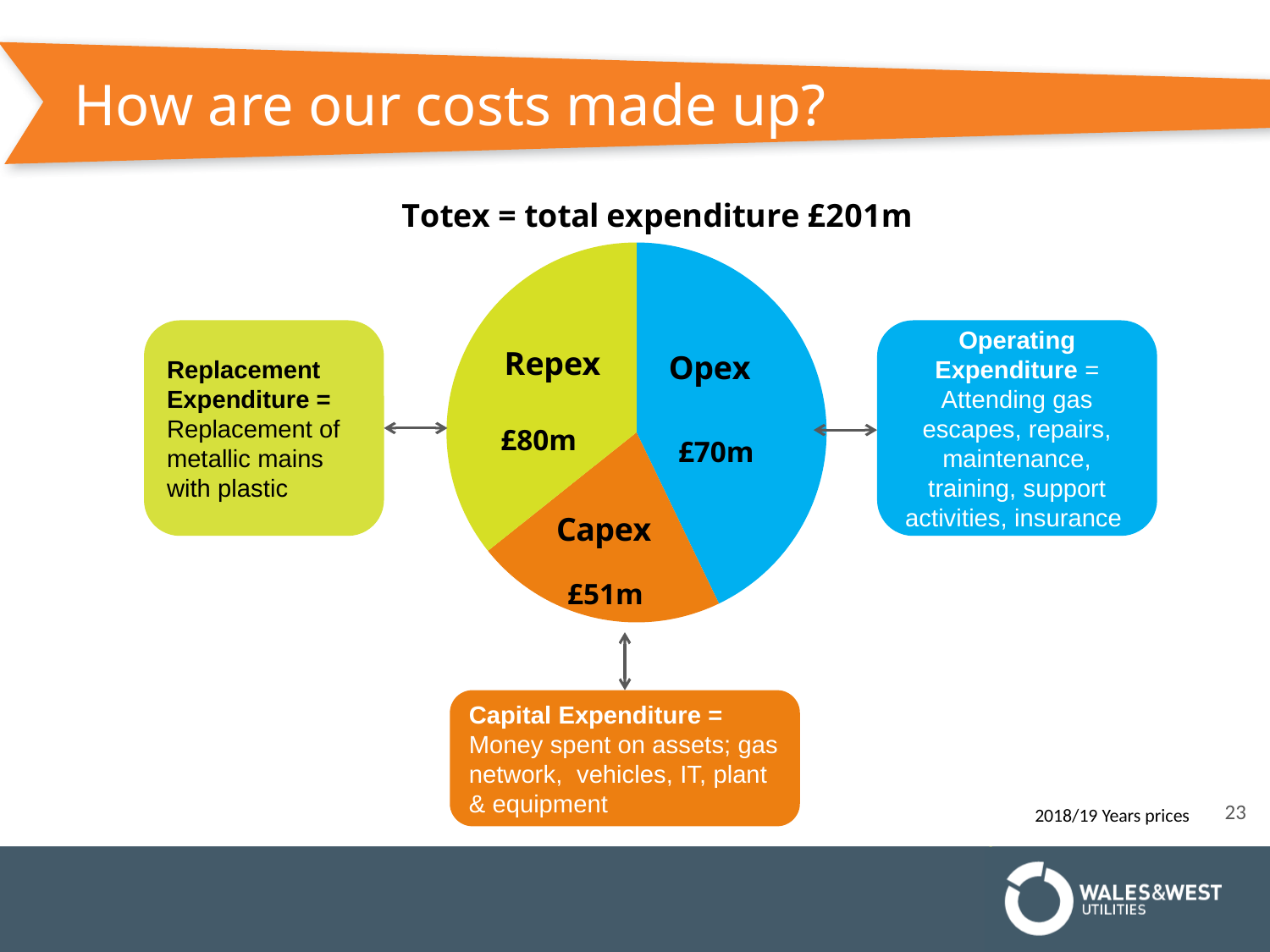
Which is larger, Opex or Capex? Opex What is the value of the Opex slice? £70m What is the value of the Repex slice? £80m What colour is the Capex slice of the pie chart? Orange What kind of chart is shown on the slide? Pie chart What is the value of the Capex slice? £51m What is the difference between the Repex and Opex values? £10m How many slices does the pie chart have? 3 What is the total expenditure (Totex) shown above the pie chart? £201m Which slice of the pie chart is the smallest? Capex What is the difference between the Repex and Capex values? £29m